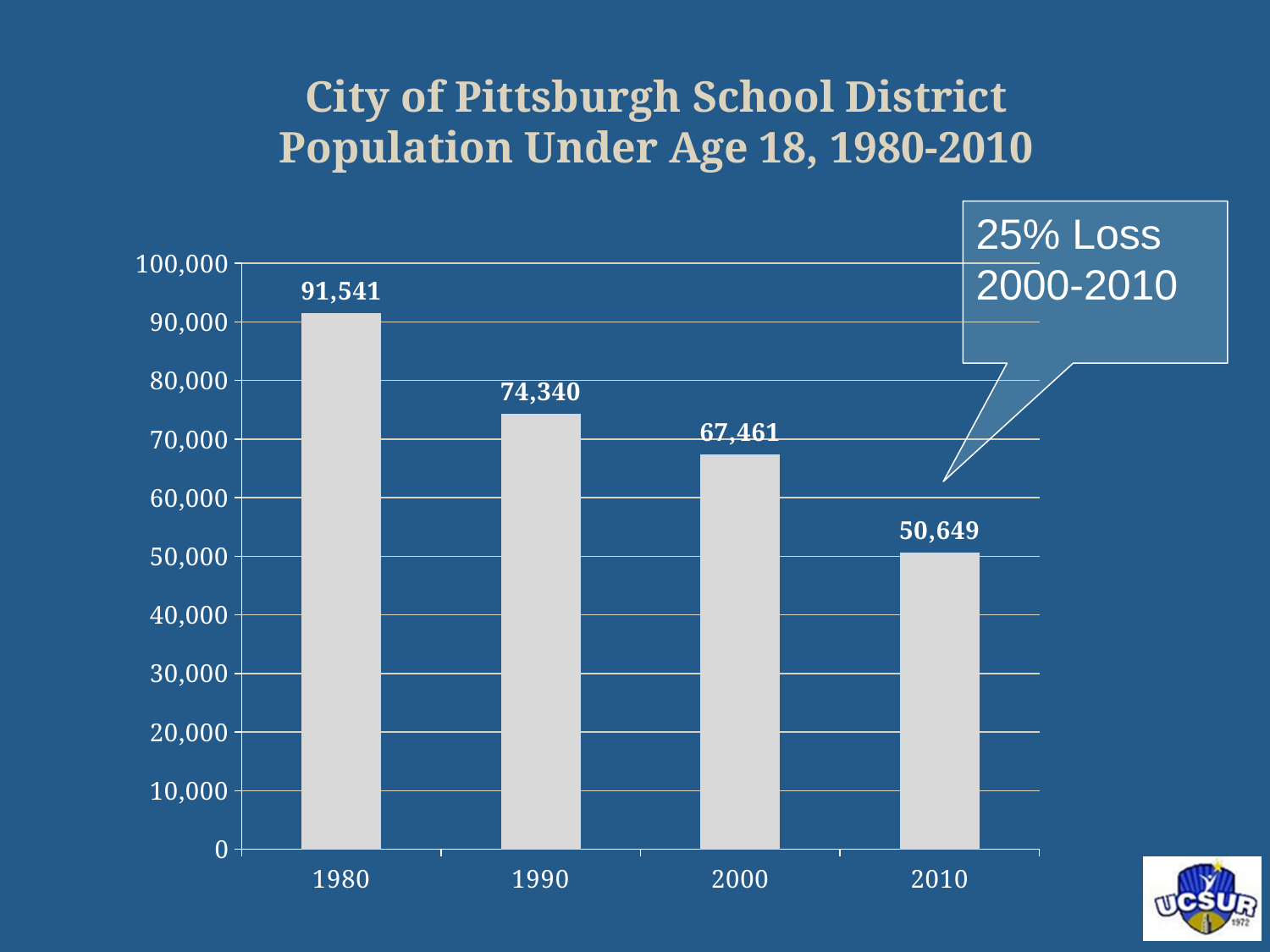
Which year has the lowest population under age 18? 2010 What kind of chart is shown on the slide? bar chart What value is shown for 1990? 74,340 What was the population under age 18 in 1980? 91,541 Which year has the highest population under age 18? 1980 How many years are shown on the x axis? 4 What was the population under age 18 in 2010? 50,649 Do the values rise or fall from 1980 to 2010? fall Which is larger, the value for 1990 or the value for 2000? 1990 Is the value for 2000 greater or less than 70,000? less What is the difference between the 1980 and 1990 values? 17,201 What is the difference between the 2000 and 2010 values? 16,812